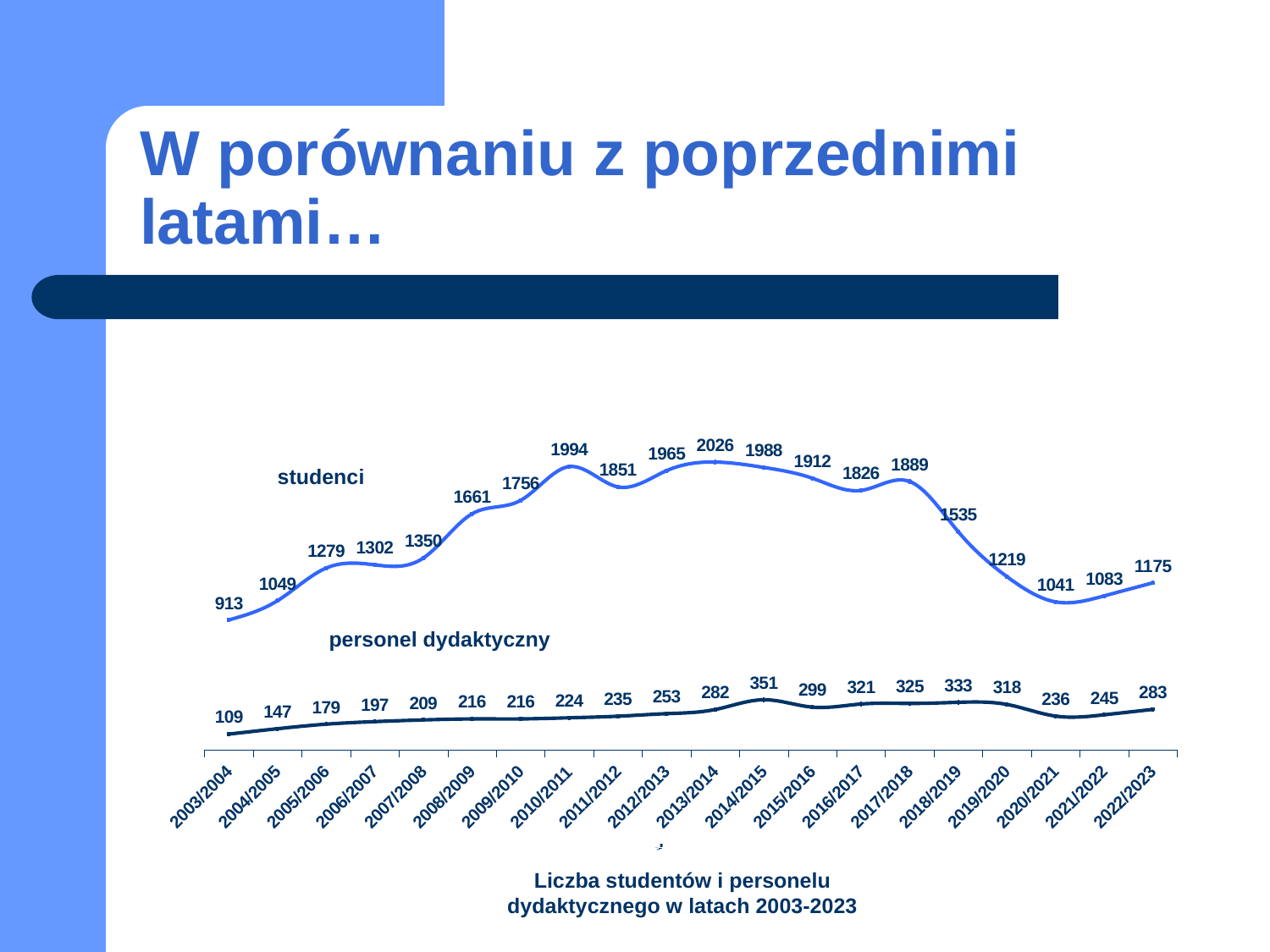
In which academic year is the studenci series at its highest? 2013/2014 How many data series does the chart show? 2 What type of chart is shown on the slide? Line chart How many academic years are plotted on the x axis? 20 What is the value for personel dydaktyczny in 2014/2015? 351 In which academic year is the personel dydaktyczny series at its lowest? 2003/2004 What is the value for studenci in 2020/2021? 1041 Which year has a higher studenci value, 2019/2020 or 2022/2023? 2019/2020 What is the difference between the studenci value in 2013/2014 and in 2003/2004? 1113 By how much did personel dydaktyczny fall from 2014/2015 to 2015/2016? 52 Does the personel dydaktyczny series rise or fall from 2003/2004 to 2014/2015? Rise How many students (studenci) are shown for 2010/2011? 1994